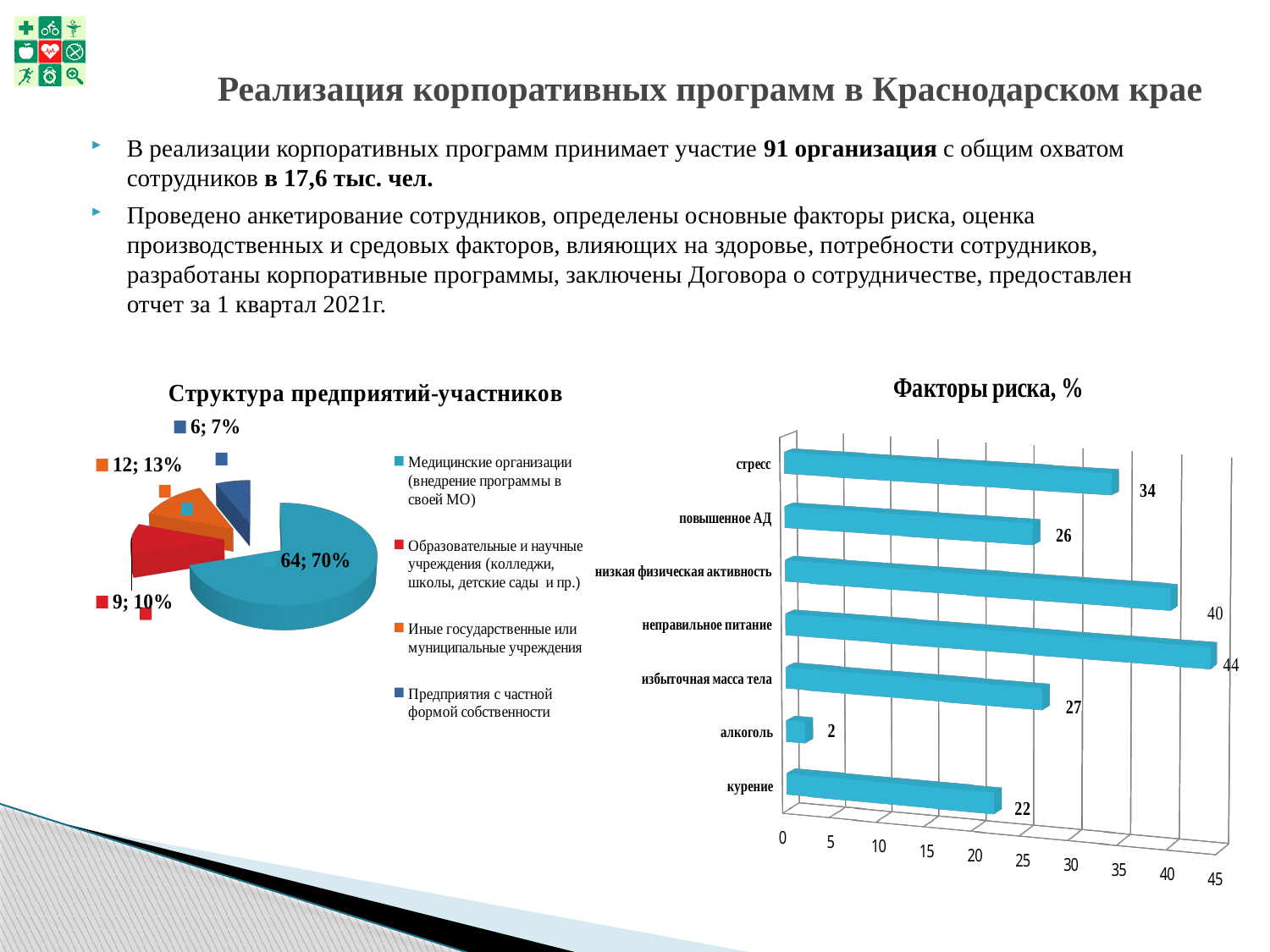
In the chart 'Факторы риска, %', what is the value for стресс? 34 In the pie chart 'Структура предприятий-участников', how many organisations are Предприятия с частной формой собственности? 6 In the chart 'Факторы риска, %', what is the value for неправильное питание? 44 In the chart 'Факторы риска, %', what is the value for алкоголь? 2 In the chart 'Факторы риска, %', which risk factor has the lowest value? алкоголь In the chart 'Факторы риска, %', what is the difference between the values for низкая физическая активность and повышенное АД? 14 In the chart 'Факторы риска, %', which is larger: the value for избыточная масса тела or the value for курение? избыточная масса тела In the chart 'Факторы риска, %', which risk factor has the highest value? неправильное питание How many risk factors are shown in the chart 'Факторы риска, %'? 7 In the pie chart 'Структура предприятий-участников', what share do Медицинские организации have? 70% What kind of chart is 'Факторы риска, %'? bar chart How many entries does the legend of the pie chart 'Структура предприятий-участников' list? 4